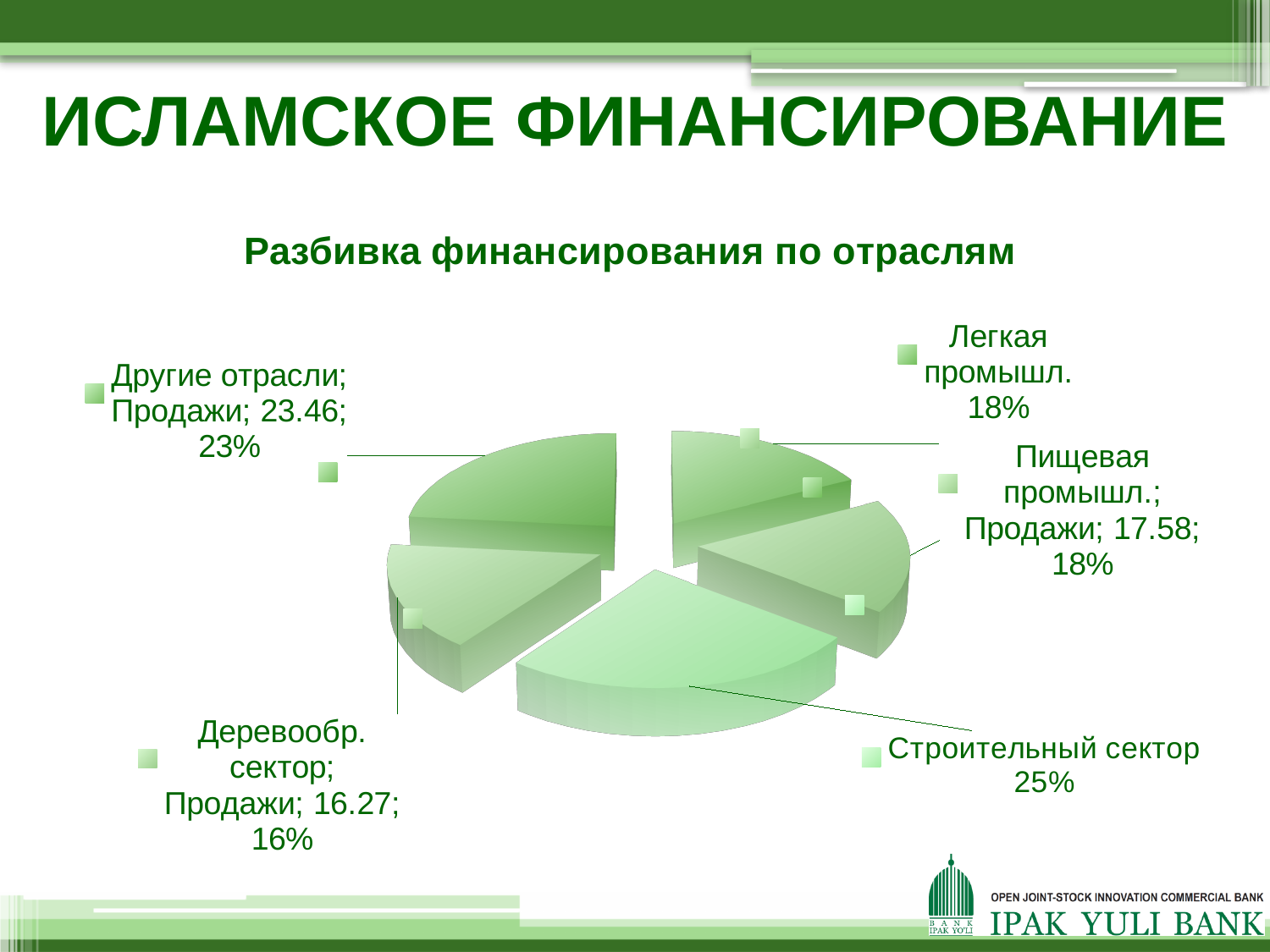
What is the value shown for Пищевая промышл.? 17.58 What kind of chart is shown on the slide? pie chart What is the value shown for Другие отрасли? 23.46 What percentage share does Строительный сектор have? 25% What is the title of the chart? Разбивка финансирования по отраслям What is the difference between the values for Другие отрасли and Деревообр. сектор? 7.19 Which sector has the largest share of the pie? Строительный сектор Which sector has the smallest share of the pie? Деревообр. сектор Which is larger, the share for Другие отрасли or the share for Деревообр. сектор? Другие отрасли What is the value shown for Деревообр. сектор? 16.27 What percentage share does Легкая промышл. have? 18% How many slices does the pie chart have? 5